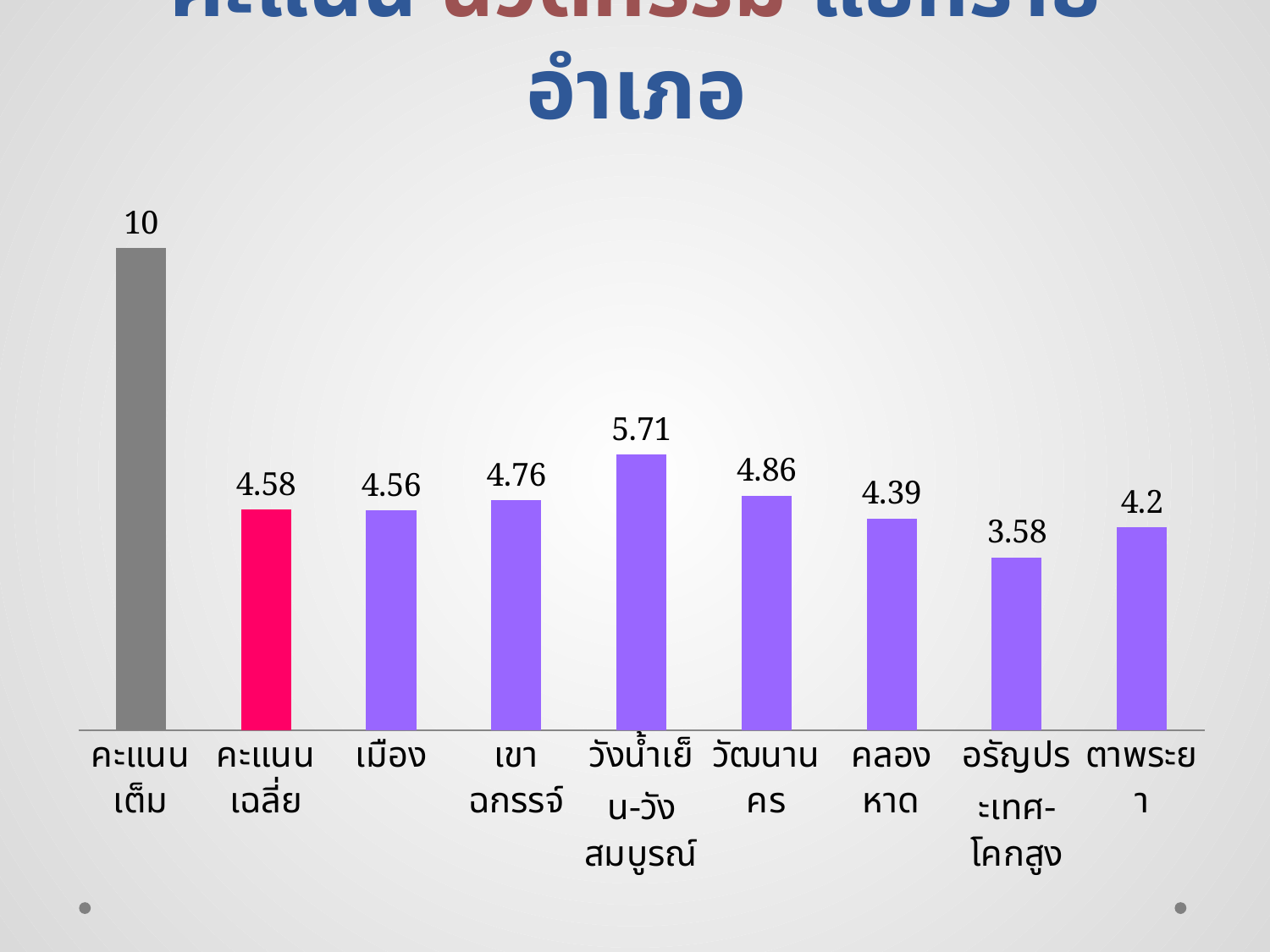
What is the value for คะแนนเฉลี่ย? 4.58 What is the difference between the values for คะแนนเต็ม and คะแนนเฉลี่ย? 5.42 What kind of chart is shown on the slide? Bar chart Which is larger, the value for วัฒนานคร or the value for คลองหาด? วัฒนานคร What is the value for วังน้ำเย็น-วังสมบูรณ์? 5.71 Which category has the highest value? คะแนนเต็ม What is the difference between the values for วังน้ำเย็น-วังสมบูรณ์ and อรัญประเทศ-โคกสูง? 2.13 What is the value for อรัญประเทศ-โคกสูง? 3.58 How many categories are shown on the x axis? 9 Which category has the lowest value? อรัญประเทศ-โคกสูง What is the value for ตาพระยา? 4.2 Excluding คะแนนเต็ม and คะแนนเฉลี่ย, which district has the highest value? วังน้ำเย็น-วังสมบูรณ์